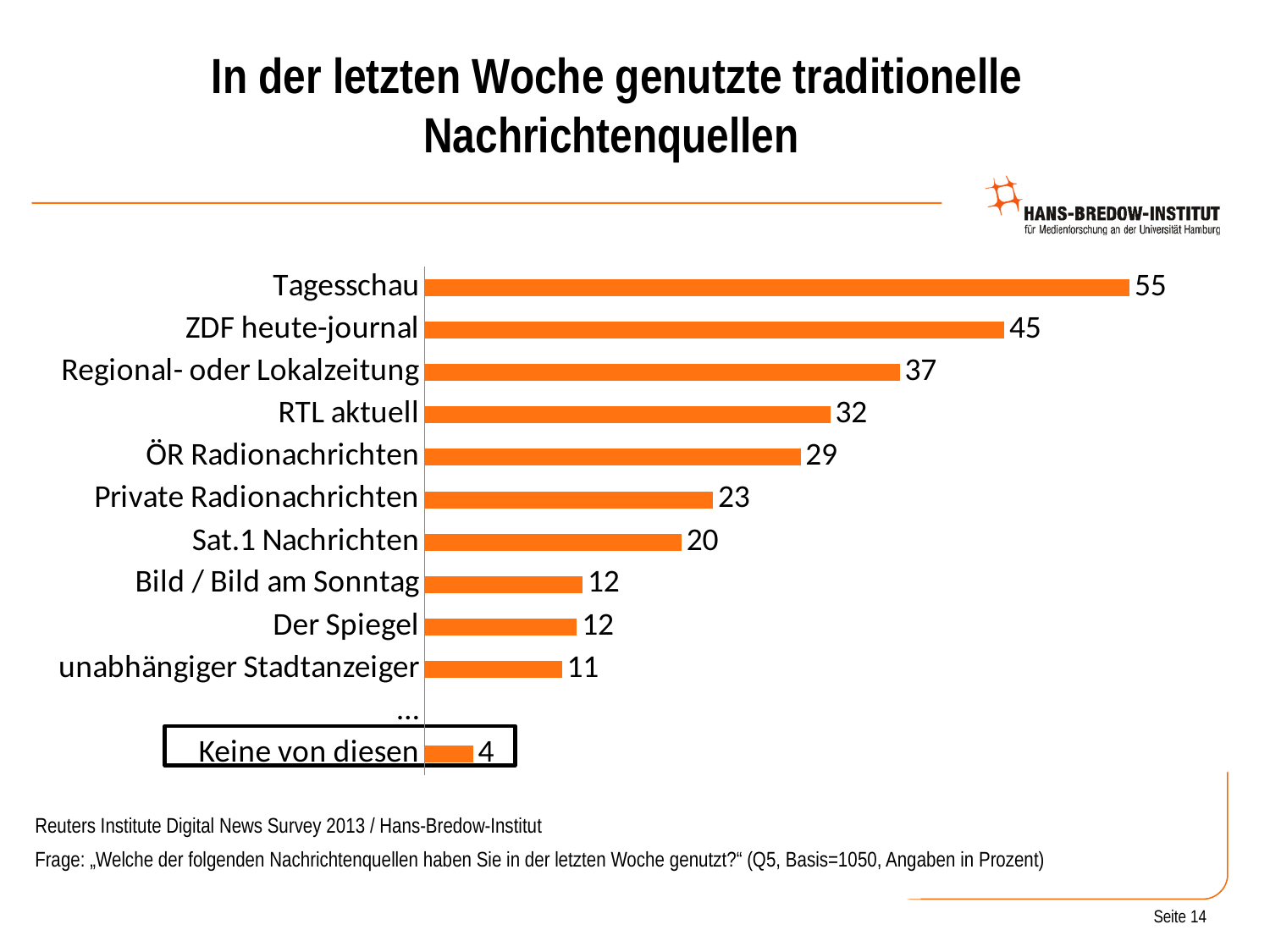
Which category has the highest value? Tagesschau What is the difference between the values for Regional- oder Lokalzeitung and Sat.1 Nachrichten? 17 What is the difference between the values for Tagesschau and ZDF heute-journal? 10 Which category has the lowest value? Keine von diesen What kind of chart is shown on the slide? bar chart What is the value for Tagesschau? 55 What is the value for RTL aktuell? 32 Which is larger, the value for ÖR Radionachrichten or the value for Private Radionachrichten? ÖR Radionachrichten What is the value for Keine von diesen? 4 What colour are the bars in the chart? orange How many categories (bars) are shown in the chart? 11 What is the value for Der Spiegel? 12